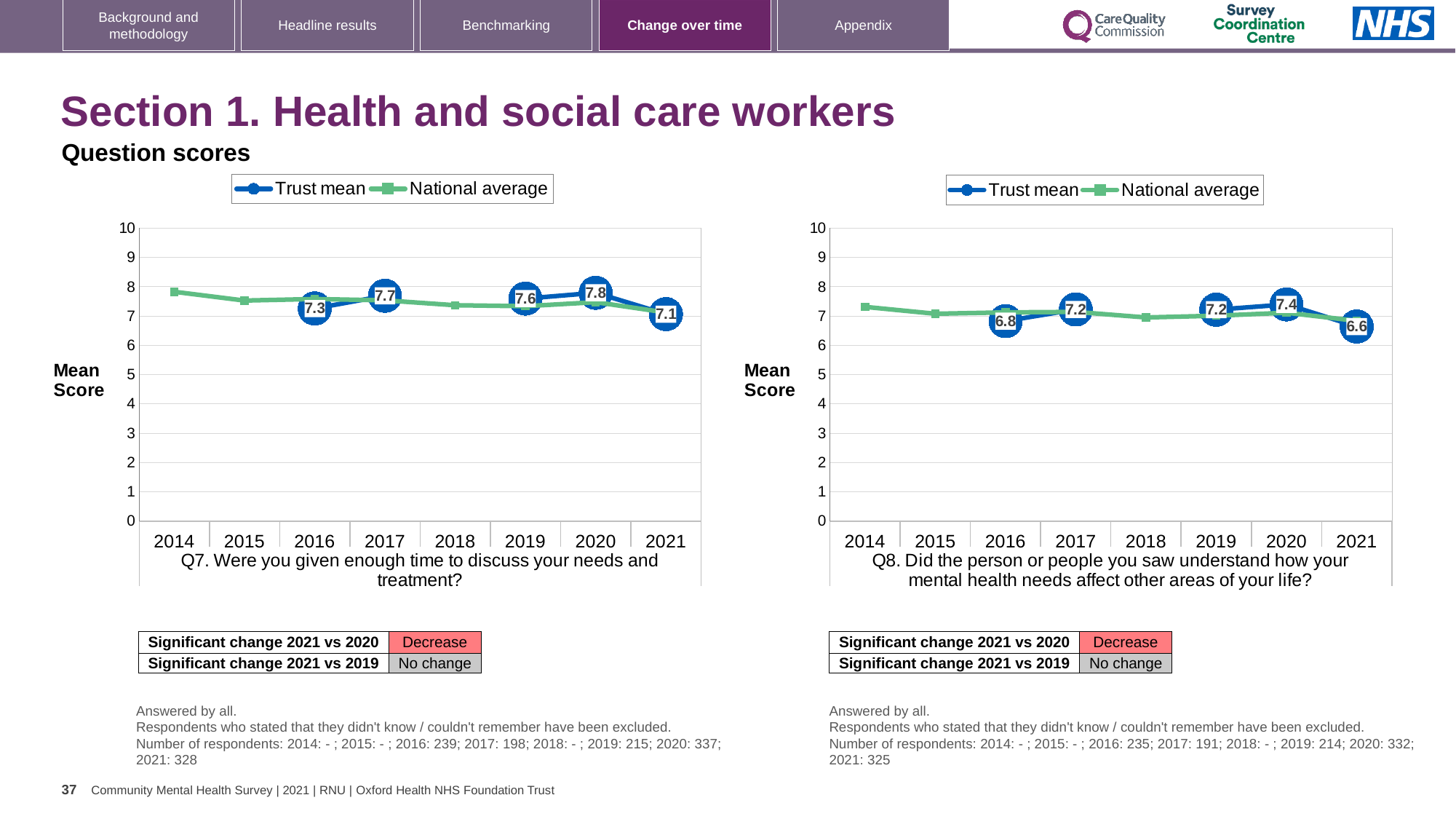
In the Q8 chart on the right, which year has the lowest labelled Trust mean? 2021 In the Q7 chart on the left, what is the Trust mean for 2021? 7.1 In the Q7 chart on the left, what is the difference between the Trust mean in 2020 and in 2021? 0.7 In the Q8 chart on the right, is the Trust mean higher in 2017 or in 2016? 2017 In the Q8 chart on the right, what is the Trust mean for 2021? 6.6 In the Q8 chart on the right, what is the Trust mean for 2016? 6.8 In the Q7 chart on the left, what is the Trust mean for 2017? 7.7 What kind of chart is the Q8 chart on the right? Line chart How many series does the legend of the Q7 chart on the left list? 2 In the Q7 chart on the left, which year has the highest labelled Trust mean? 2020 In the Q7 chart on the left, is the National average for 2014 greater or less than 7? greater In the Q8 chart on the right, what is the difference between the Trust mean in 2020 and in 2021? 0.8